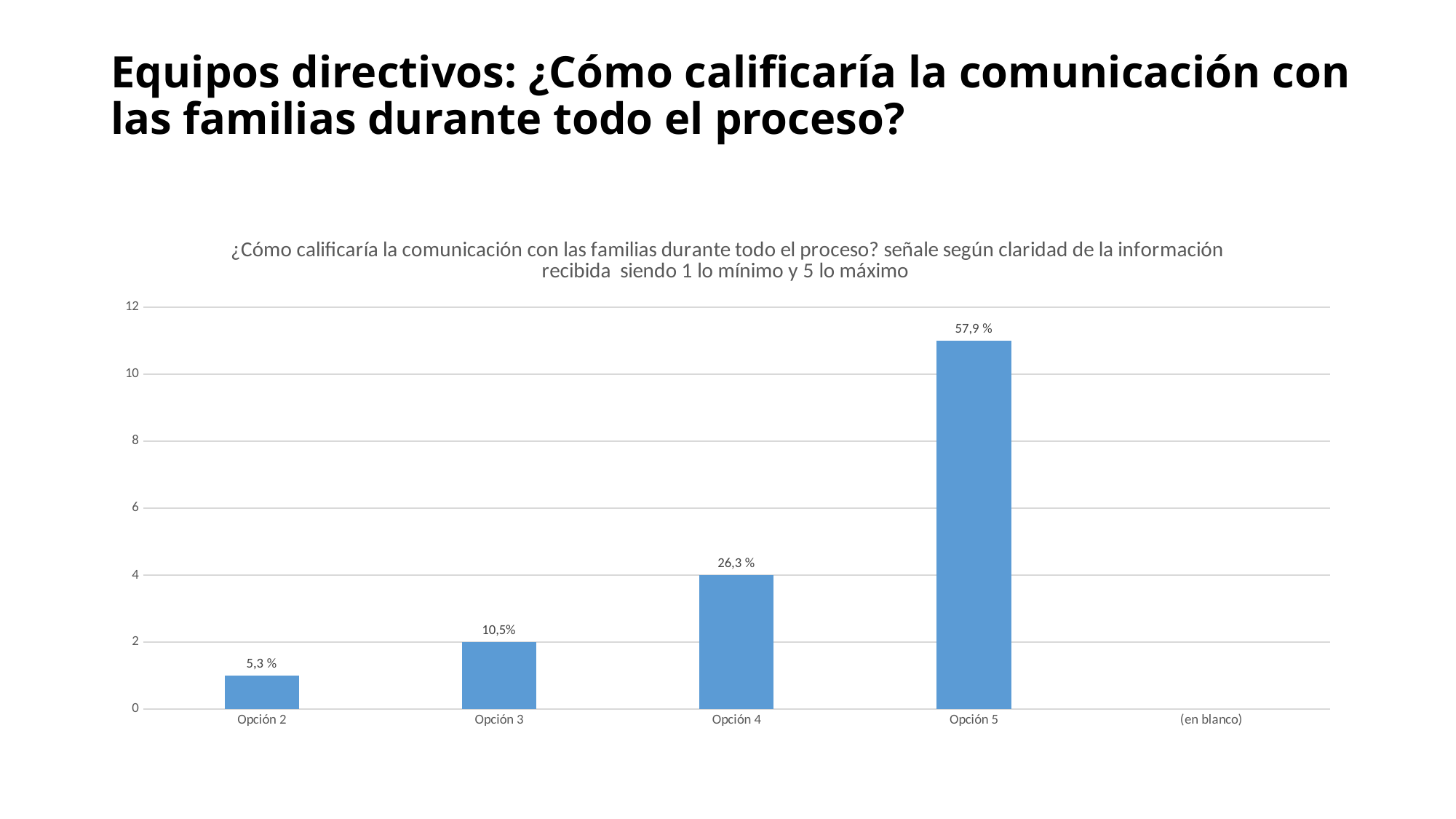
What kind of chart is shown on the slide? bar chart Do the bar values rise or fall from Opción 2 to Opción 5? rise What is the data label shown for Opción 2? 5,3 % How many categories are shown on the x axis? 5 What is the data label shown for Opción 3? 10,5% What is the difference between the percentage labels for Opción 5 and Opción 4? 31,6 % Which is larger, the value for Opción 3 or the value for Opción 4? Opción 4 What is the data label shown for Opción 4? 26,3 % What is the data label shown for Opción 5? 57,9 % Is the bar for Opción 5 greater or less than 10 on the vertical axis? greater Which category has the highest bar? Opción 5 Which category with a visible bar has the lowest value? Opción 2